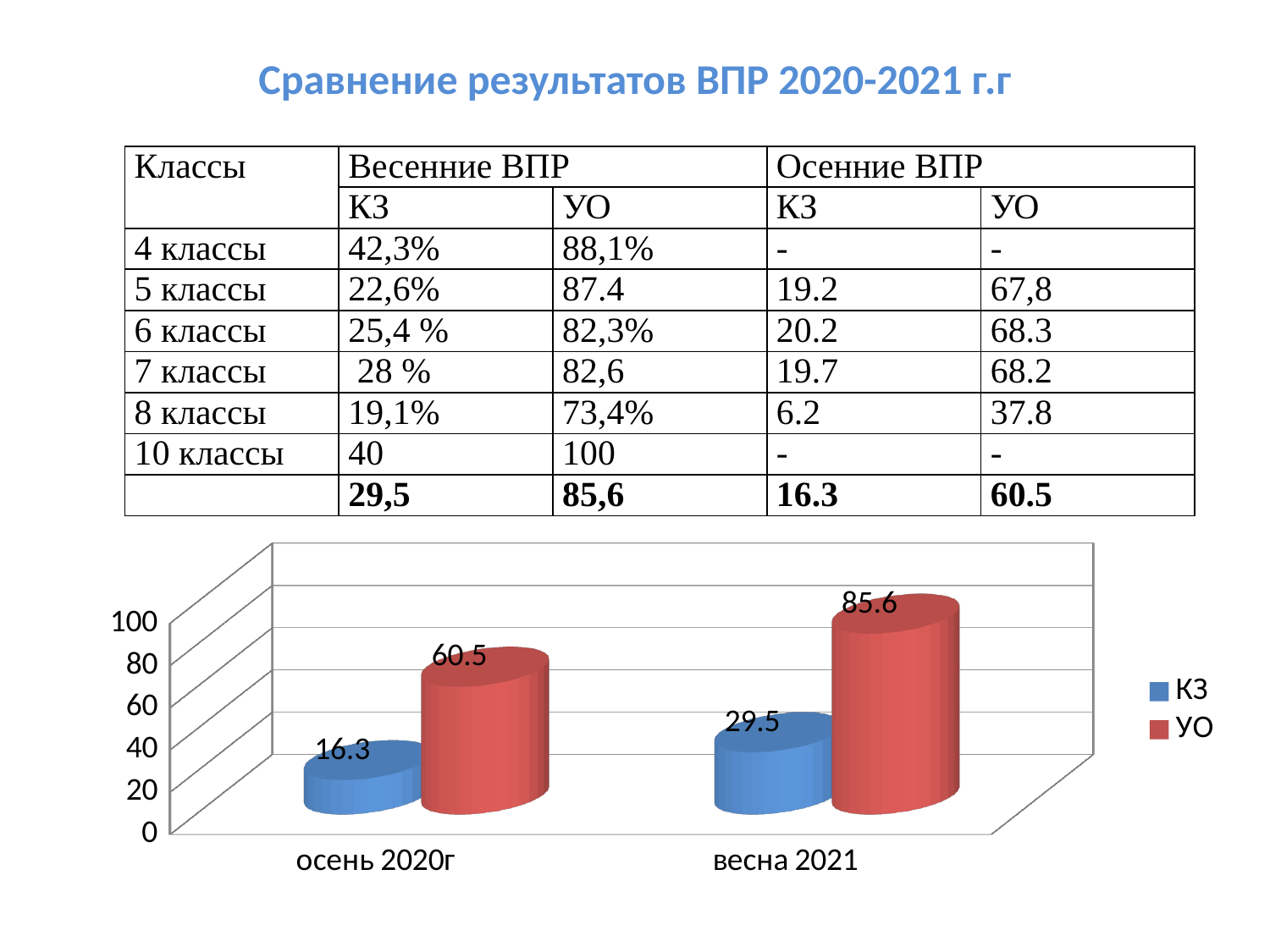
Which category has the lowest КЗ value? осень 2020г What is the value of КЗ for весна 2021? 29.5 Is the value of УО for осень 2020г greater or less than 80? less What is the value of УО for весна 2021? 85.6 What is the value of УО for осень 2020г? 60.5 How many categories are shown on the x axis of the chart? 2 What is the difference between the УО values for весна 2021 and осень 2020г? 25.1 How many series does the chart legend list? 2 Which is larger: КЗ for весна 2021 or КЗ for осень 2020г? КЗ for весна 2021 What type of chart is shown on the slide? bar chart Which category has the highest УО value? весна 2021 What is the value of КЗ for осень 2020г? 16.3